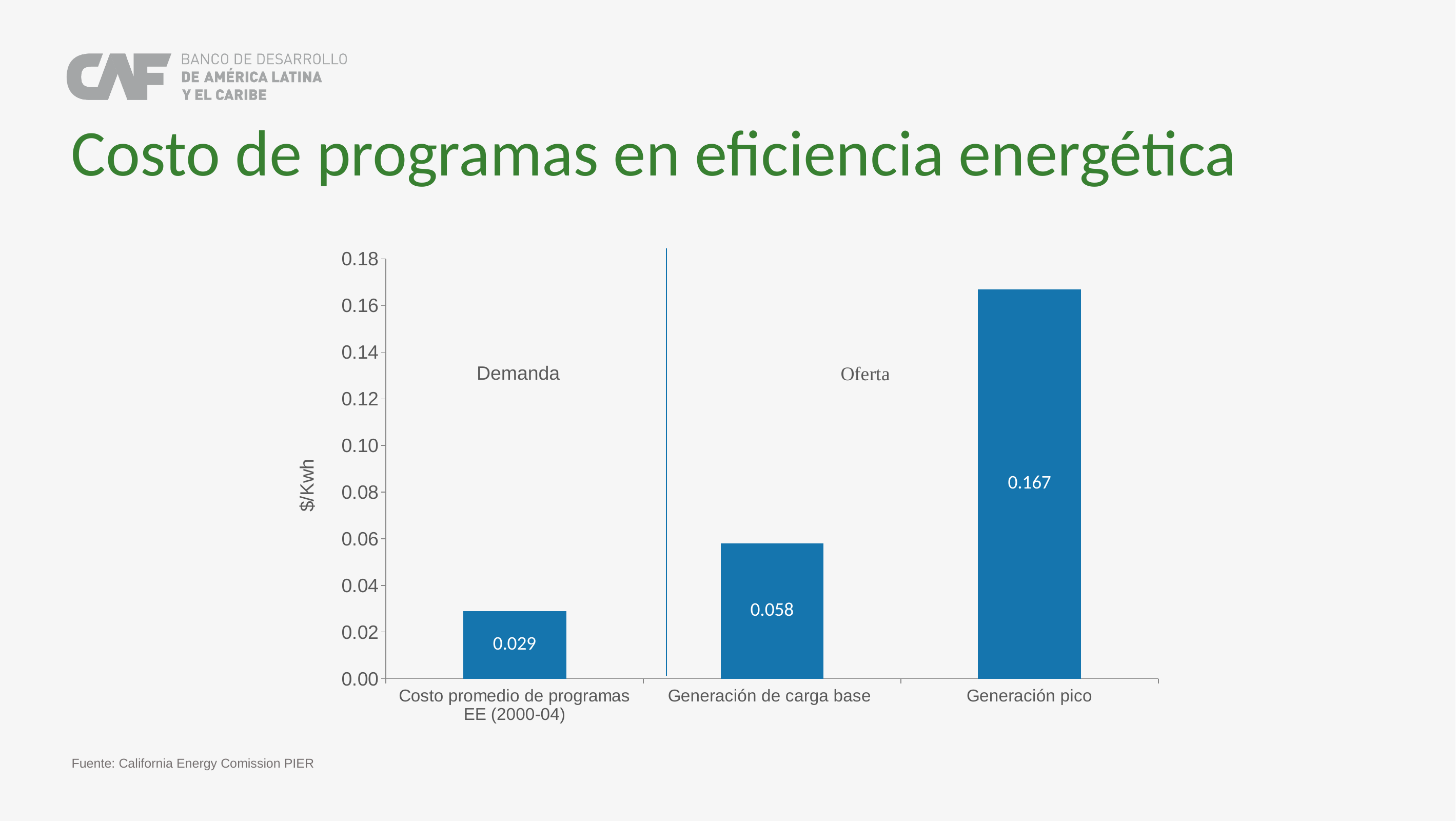
What is the value for Generación de carga base? 0.058 Is the value for Generación pico greater or less than 0.14? greater Which category has the lowest value? Costo promedio de programas EE (2000-04) What is the label on the vertical axis of the chart? $/Kwh What kind of chart is shown on the slide? Bar chart Which category has the highest value? Generación pico What is the value for Generación pico? 0.167 How many categories are shown on the chart? 3 Which is larger, the value for Generación de carga base or the value for Costo promedio de programas EE (2000-04)? Generación de carga base What is the value for Costo promedio de programas EE (2000-04)? 0.029 What is the difference between the values for Generación pico and Generación de carga base? 0.109 What is the difference between the values for Generación de carga base and Costo promedio de programas EE (2000-04)? 0.029